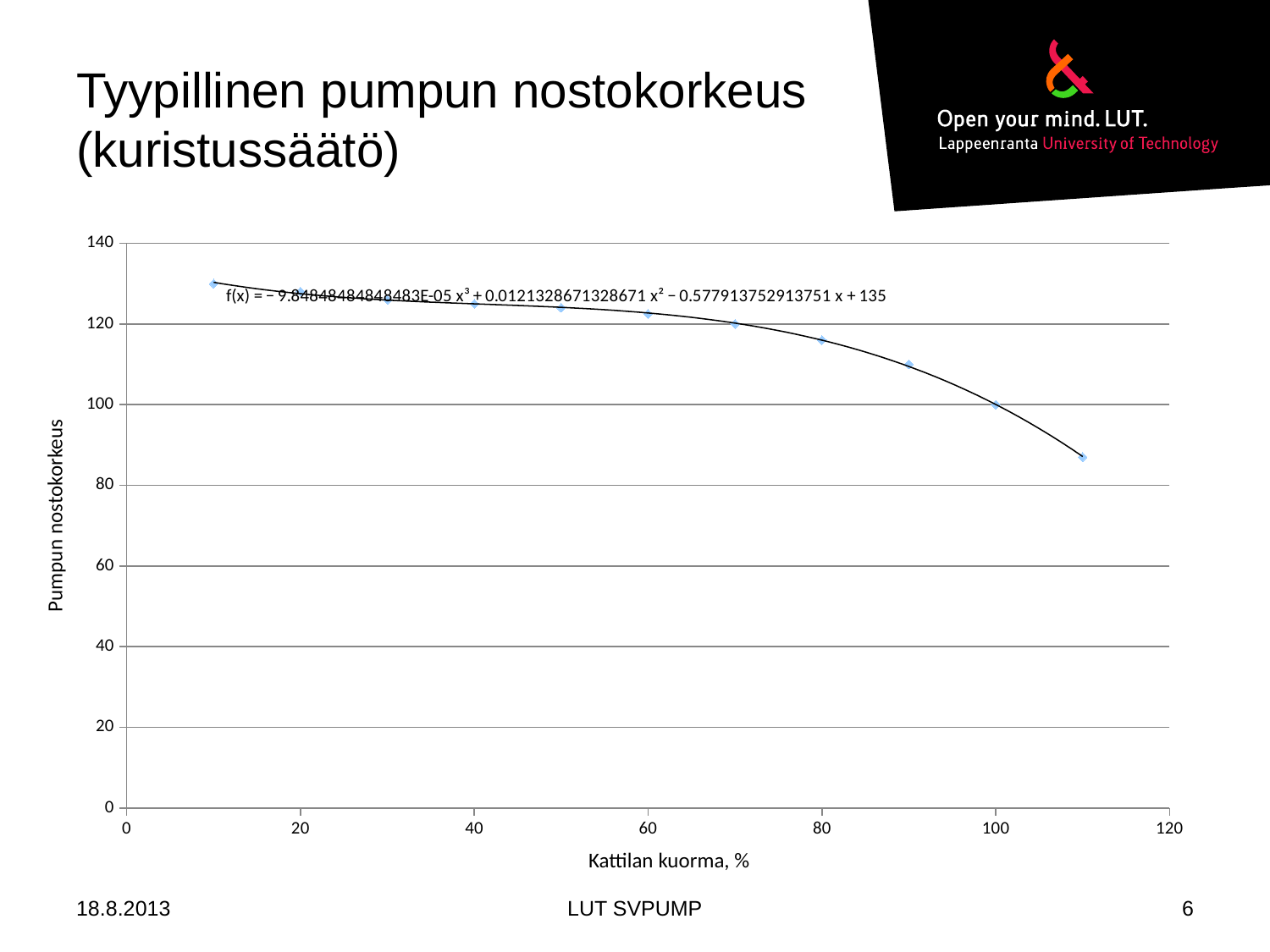
What is the Pumpun nostokorkeus at a Kattilan kuorma of 100%? 100 What is the label of the y axis? Pumpun nostokorkeus What is the label of the x axis? Kattilan kuorma, % What kind of chart is shown on the slide? scatter chart Is the Pumpun nostokorkeus at a Kattilan kuorma of 10% greater or less than 120? greater At which Kattilan kuorma value is the Pumpun nostokorkeus lowest? 110 Is the Pumpun nostokorkeus at a Kattilan kuorma of 110% greater or less than 100? less Do the plotted values rise or fall as Kattilan kuorma increases along the x axis? fall How many data points are plotted on the chart? 11 At which Kattilan kuorma value is the Pumpun nostokorkeus highest? 10 Which is larger, the Pumpun nostokorkeus at a Kattilan kuorma of 20% or at 90%? 20% Is the Pumpun nostokorkeus at a Kattilan kuorma of 80% greater or less than 120? less